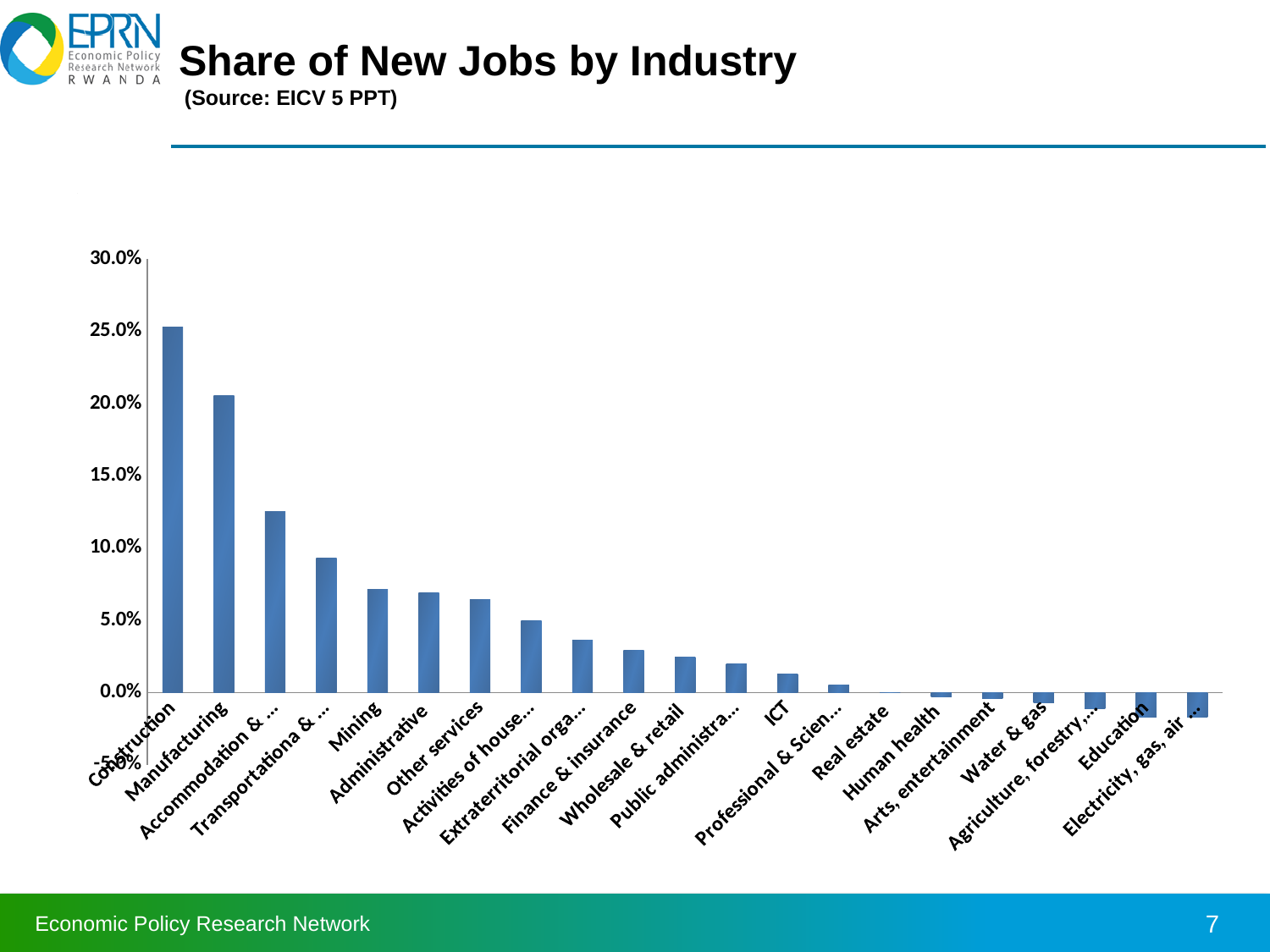
Is the value for Construction greater or less than 20.0%? greater Is the value for Finance & insurance greater or less than 5.0%? less What kind of chart is shown on the slide? bar chart Do the bar values generally rise or fall moving from left to right along the x axis? fall Which has a larger share of new jobs, Construction or Manufacturing? Construction Is the value for Transportationa & ... greater or less than 10.0%? less Which industry has the highest share of new jobs? Construction How many industries (bars) are plotted in the chart? 21 What is the title of the chart? Share of New Jobs by Industry